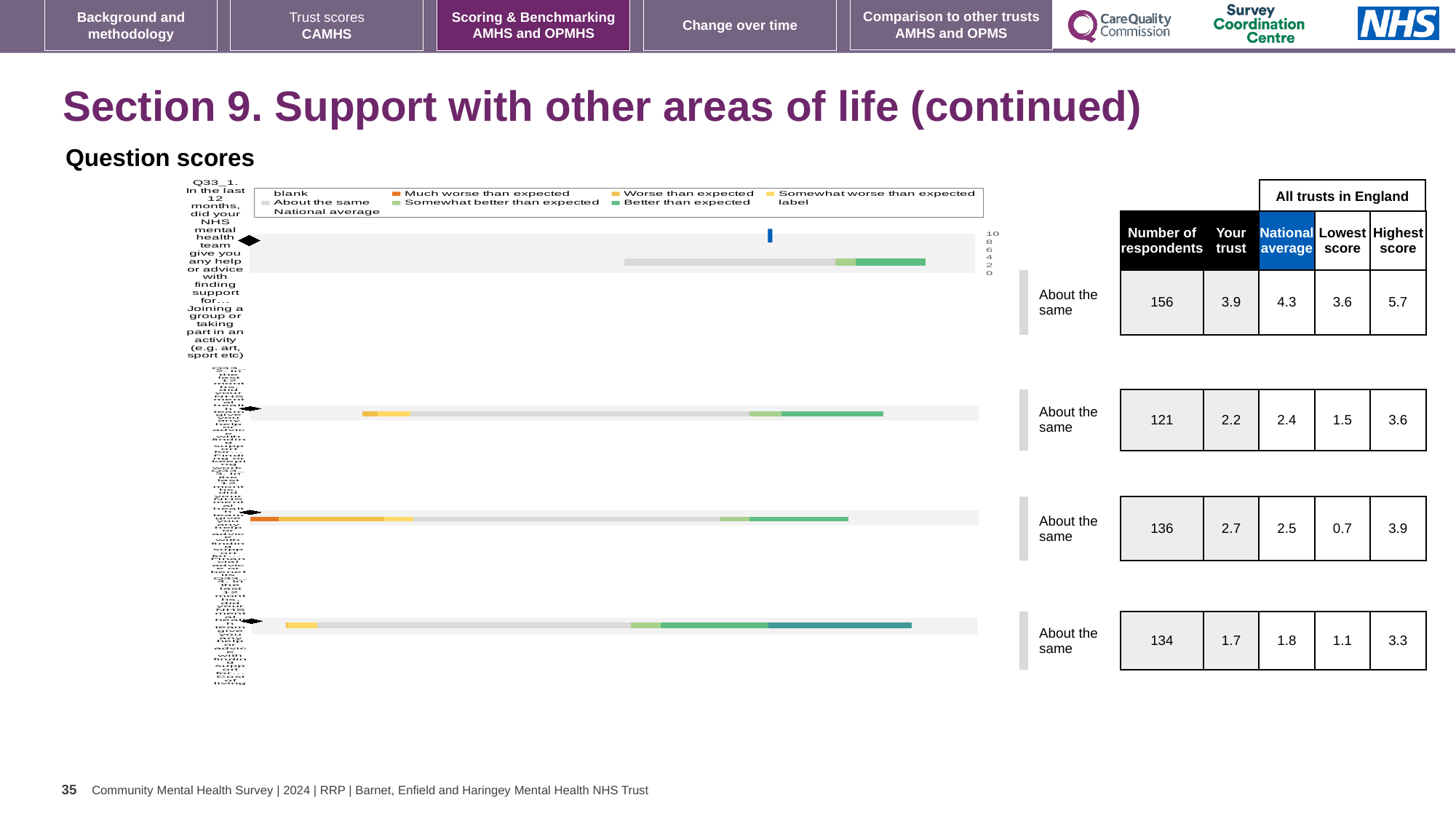
How many horizontal bar rows are plotted in the chart? 4 Which row in the table beside the chart has the highest "Your trust" score? The first row (Q33_1), 3.9 For the first row (Q33_1), what is the difference between the national average (4.3) and the "Your trust" score (3.9)? 0.4 In the table beside the chart, what is the "Your trust" score for the first row (Q33_1, joining a group or taking part in an activity)? 3.9 For the first row (Q33_1), which is larger: the "Your trust" score or the national average? National average Which legend entry is shown in orange in the chart's legend? Much worse than expected Which legend entry is shown in dark green in the chart's legend? Better than expected In the table beside the chart, what is the highest score for the first row (Q33_1)? 5.7 Which row in the table beside the chart has the lowest "Your trust" score? The fourth (bottom) row, 1.7 What kind of chart is shown under the heading "Question scores"? bar chart How many entries does the legend of the chart list? 9 In the table beside the chart, what is the number of respondents for the first row (Q33_1)? 156